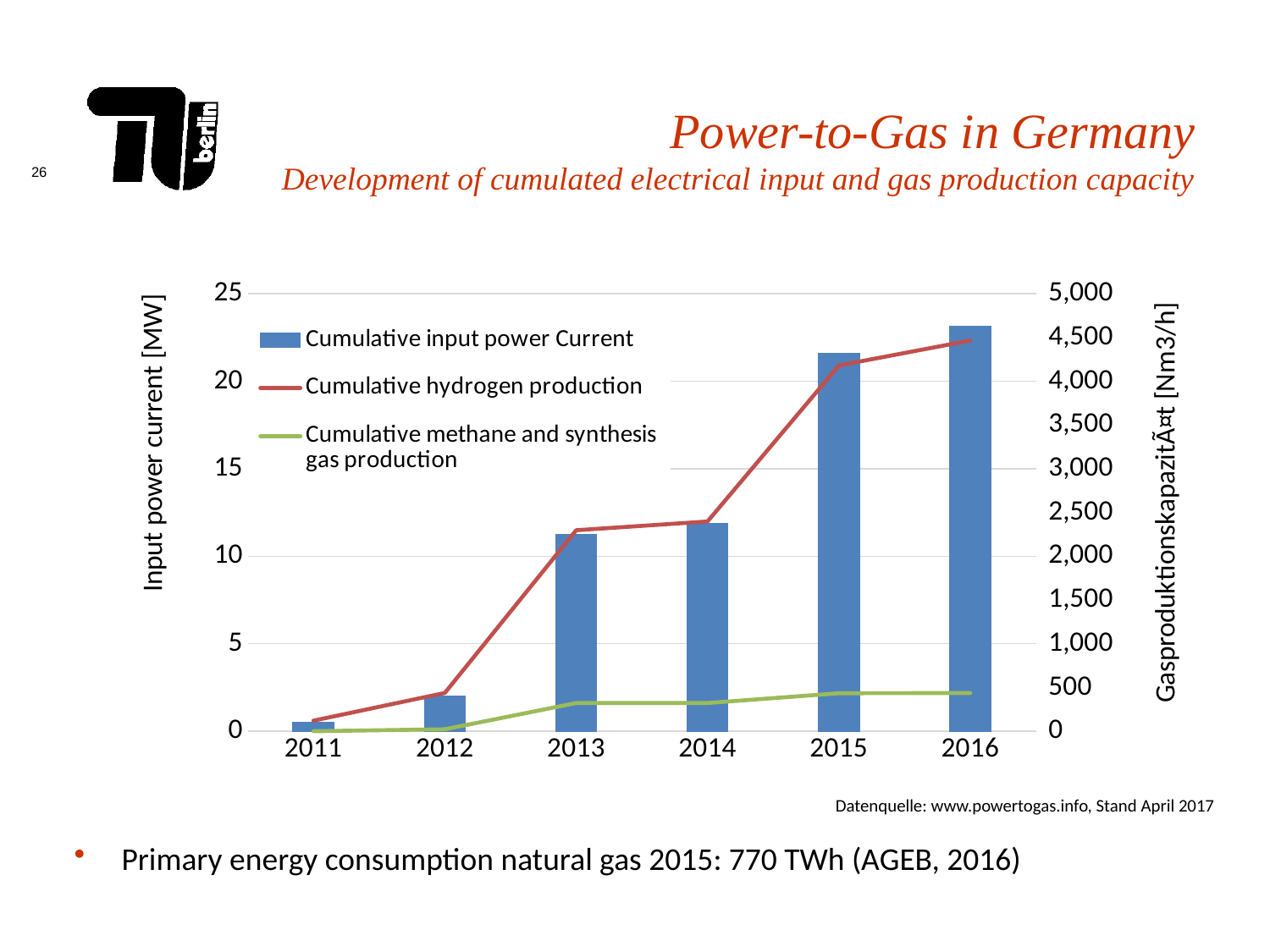
How many series does the chart legend list? 3 Which year has the larger cumulative input power bar, 2014 or 2015? 2015 What is the label of the left vertical axis of the chart? Input power current [MW] Is the cumulative input power bar for 2012 greater or less than 5 MW? less Is the cumulative input power bar for 2016 greater or less than 20 MW? greater Which year has the highest cumulative input power bar? 2016 What kind of chart is shown on the slide? Combined bar and line chart Does the cumulative hydrogen production line rise or fall from 2011 to 2016? rise Which year has the lowest cumulative input power bar? 2011 How many years are shown on the x axis of the chart? 6 Is the cumulative hydrogen production value for 2015 greater or less than 4,000 Nm3/h? greater